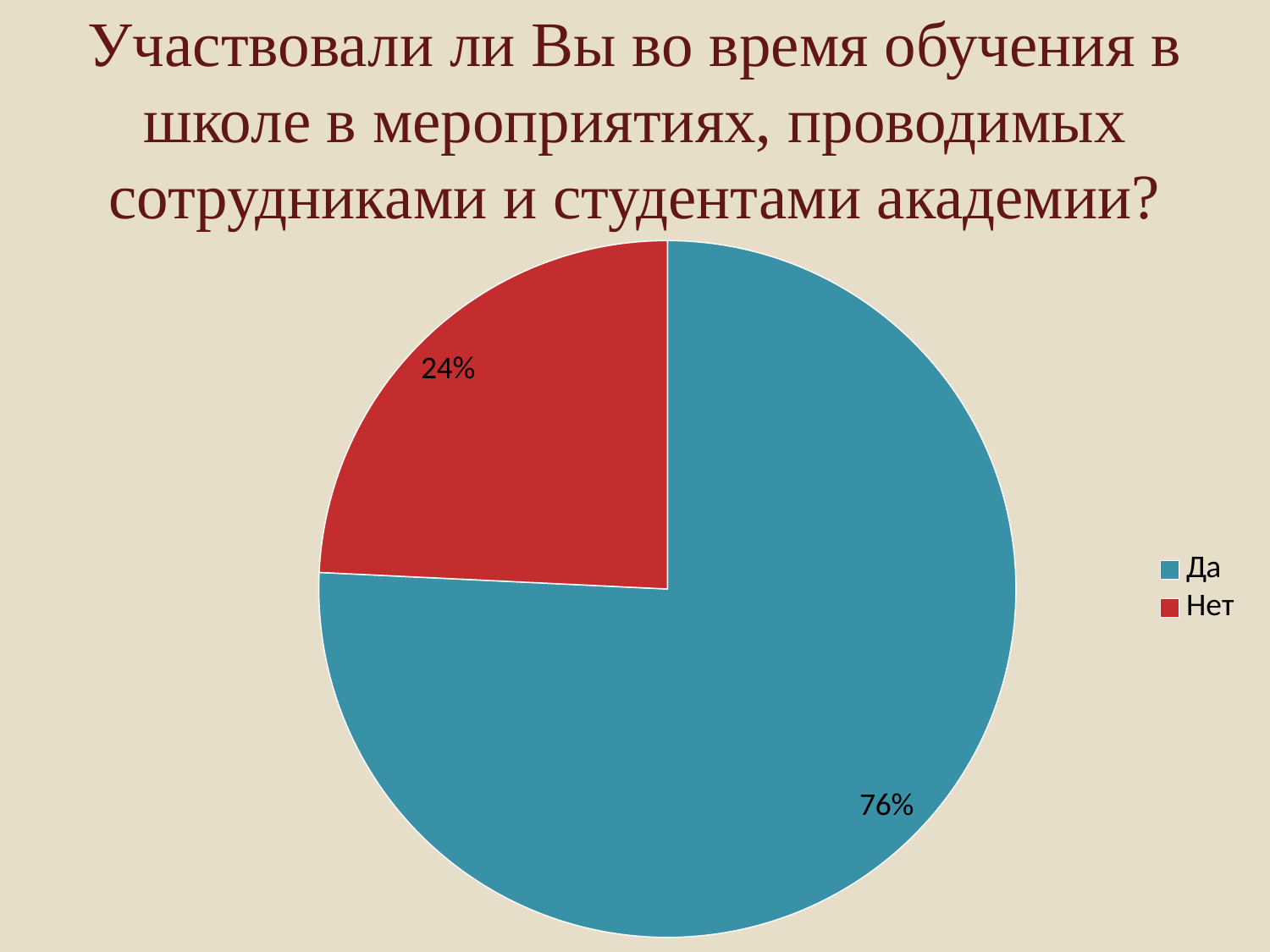
What colour is the "Нет" slice? Red Which category has the smallest slice of the pie? Нет What share of the pie does the "Нет" slice represent? 24% Which is larger, the "Да" slice or the "Нет" slice? Да What colour is the "Да" slice? Blue What is the difference in percentage points between the "Да" and "Нет" slices? 52 How many categories are shown in the pie chart? 2 Which category has the largest slice of the pie? Да What kind of chart is shown on the slide? Pie chart What share of the pie does the "Да" slice represent? 76%